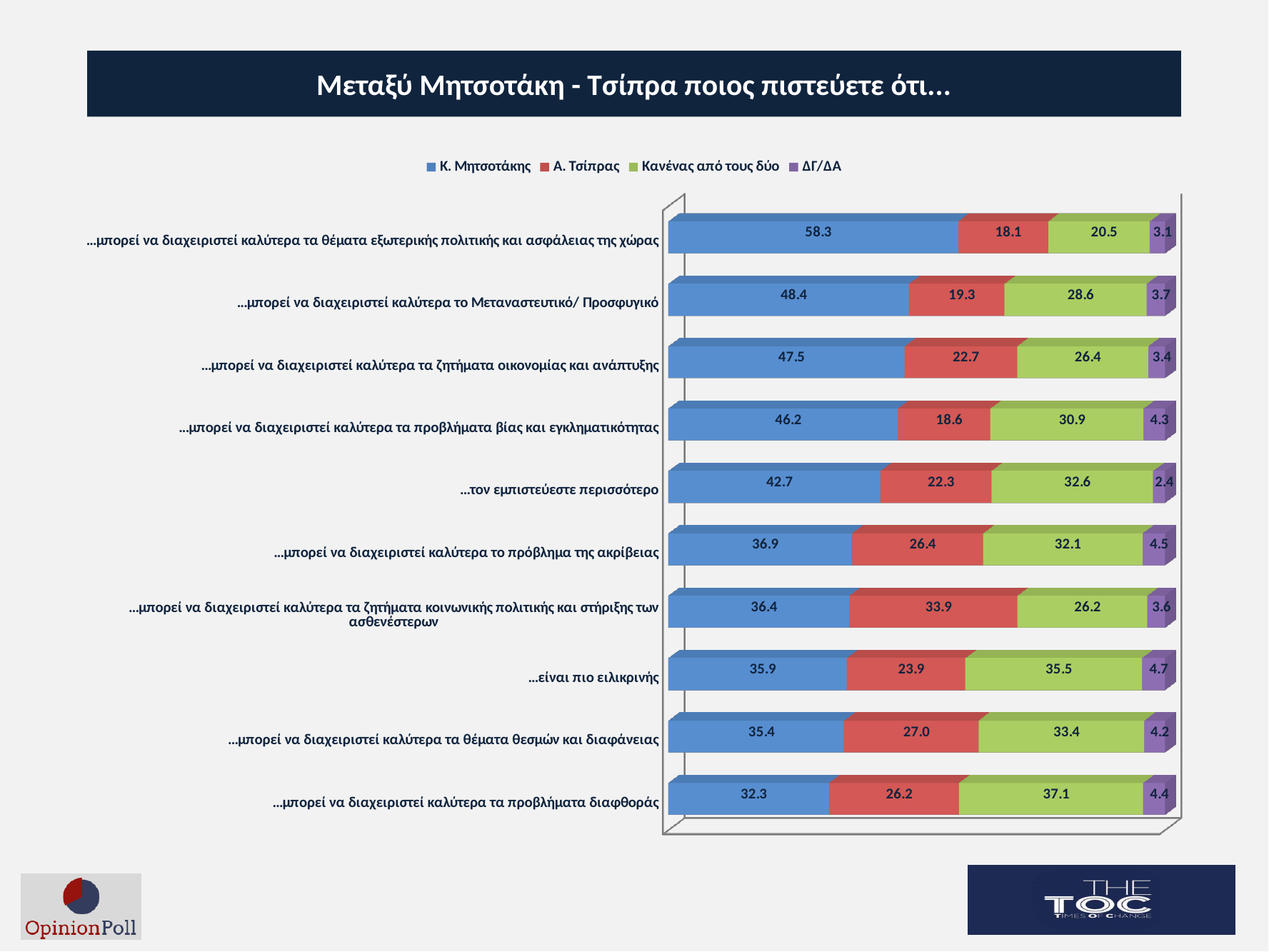
In which category does Κανένας από τους δύο have the highest value? ...μπορεί να διαχειριστεί καλύτερα τα προβλήματα διαφθοράς In which category does Κ. Μητσοτάκης have the lowest value? ...μπορεί να διαχειριστεί καλύτερα τα προβλήματα διαφθοράς How many categories (statements) are plotted in the chart? 10 What is the difference between the Κ. Μητσοτάκης and Α. Τσίπρας values in the category '...μπορεί να διαχειριστεί καλύτερα τα θέματα εξωτερικής πολιτικής και ασφάλειας της χώρας'? 40.2 In the category '...μπορεί να διαχειριστεί καλύτερα το πρόβλημα της ακρίβειας', which is larger: the value for Α. Τσίπρας or for Κανένας από τους δύο? Κανένας από τους δύο What is the value for ΔΓ/ΔΑ in the category '...τον εμπιστεύεστε περισσότερο'? 2.4 What is the total of the stacked bar for '...μπορεί να διαχειριστεί καλύτερα τα προβλήματα διαφθοράς'? 100.0 What is the value for Κ. Μητσοτάκης in the category '...μπορεί να διαχειριστεί καλύτερα τα θέματα εξωτερικής πολιτικής και ασφάλειας της χώρας'? 58.3 How many series does the legend list? 4 What is the value for Α. Τσίπρας in the category '...μπορεί να διαχειριστεί καλύτερα τα ζητήματα κοινωνικής πολιτικής και στήριξης των ασθενέστερων'? 33.9 What kind of chart is shown on the slide? Stacked bar chart What is the value for Κανένας από τους δύο in the category '...είναι πιο ειλικρινής'? 35.5